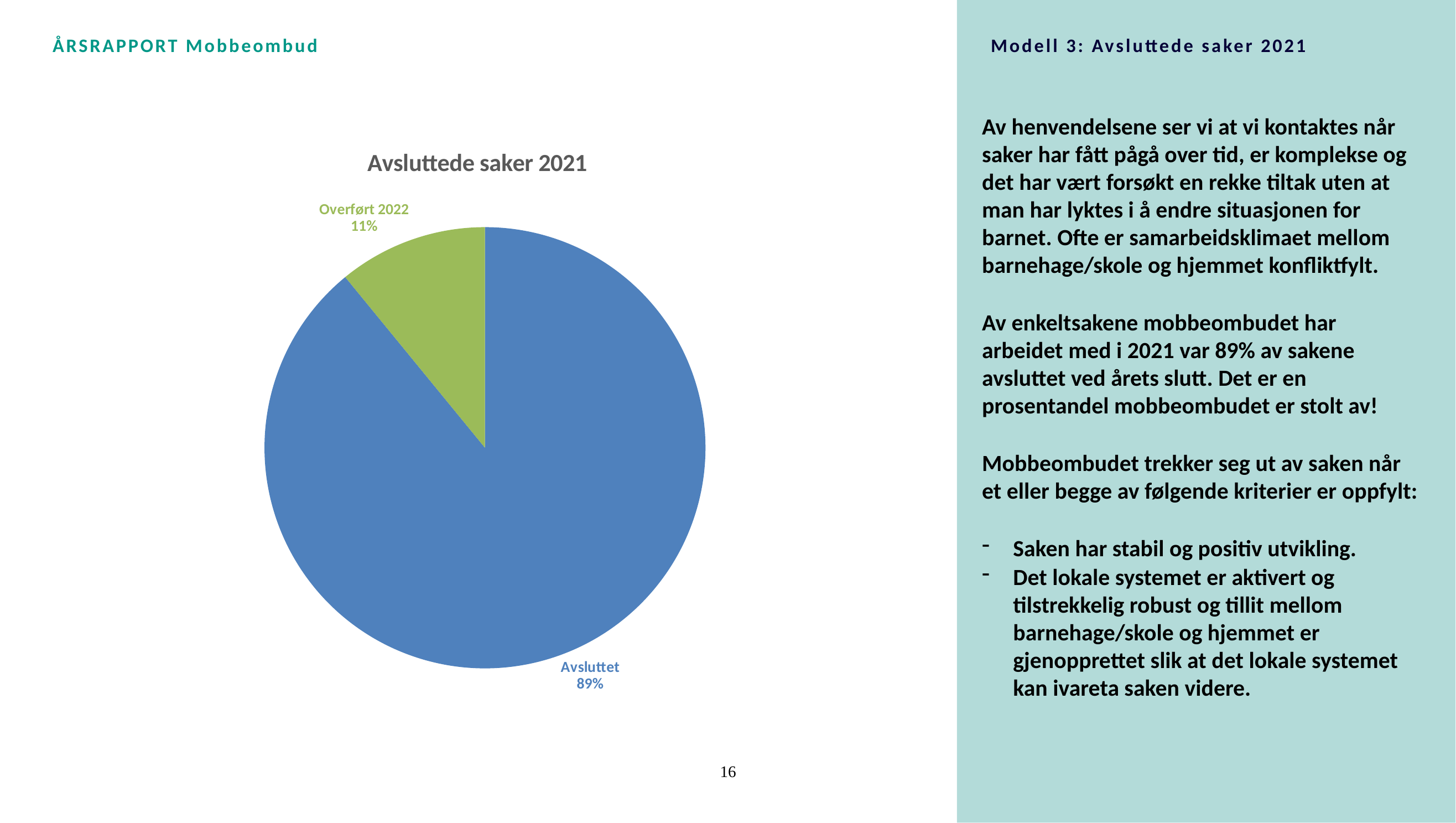
Which slice is the largest? Avsluttet What share of the pie does Overført 2022 represent? 11% What is the difference in percentage points between Avsluttet and Overført 2022? 78 What colour is the Overført 2022 slice? green Which is larger, Avsluttet or Overført 2022? Avsluttet Which slice is the smallest? Overført 2022 What is the title of the chart? Avsluttede saker 2021 How many slices does the pie chart have? 2 What share of the pie does Avsluttet represent? 89% What kind of chart is shown on the slide? pie chart